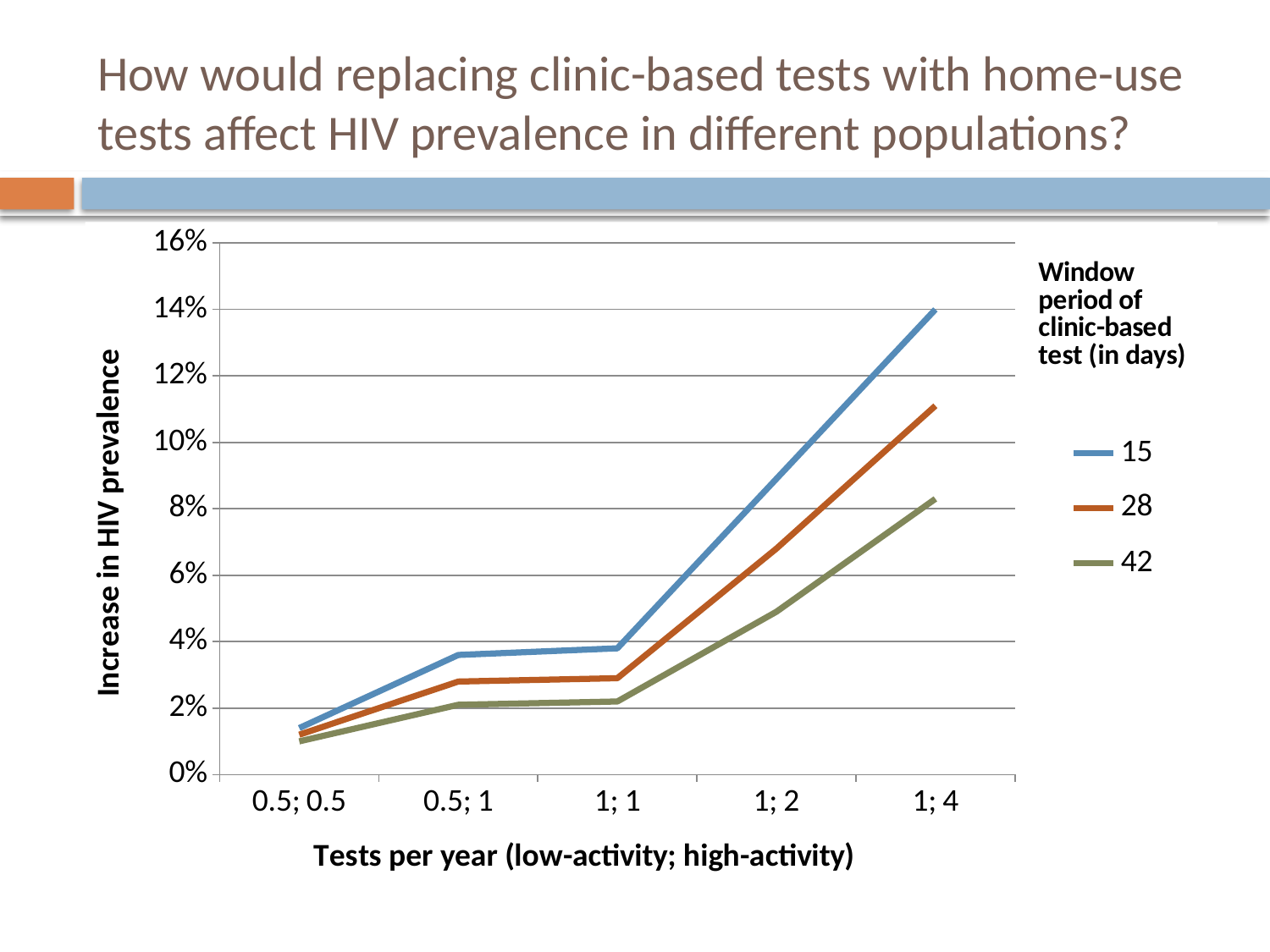
At "1; 2", which series has the larger value, 15 or 42? 15 Do the values for series 28 rise or fall from "0.5; 0.5" to "1; 4"? rise Is the value for series 42 at "1; 4" greater or less than 10%? less Which series has the highest value at "1; 4"? 15 For the series 15, which category has the highest value? 1; 4 Is the value for series 15 at "1; 4" greater or less than 12%? greater How many categories are shown on the x axis? 5 What is the title of the legend? Window period of clinic-based test (in days) Which series has the lowest value at "1; 4"? 42 What kind of chart is shown on the slide? line chart How many series does the legend list? 3 For the series 42, which category has the lowest value? 0.5; 0.5